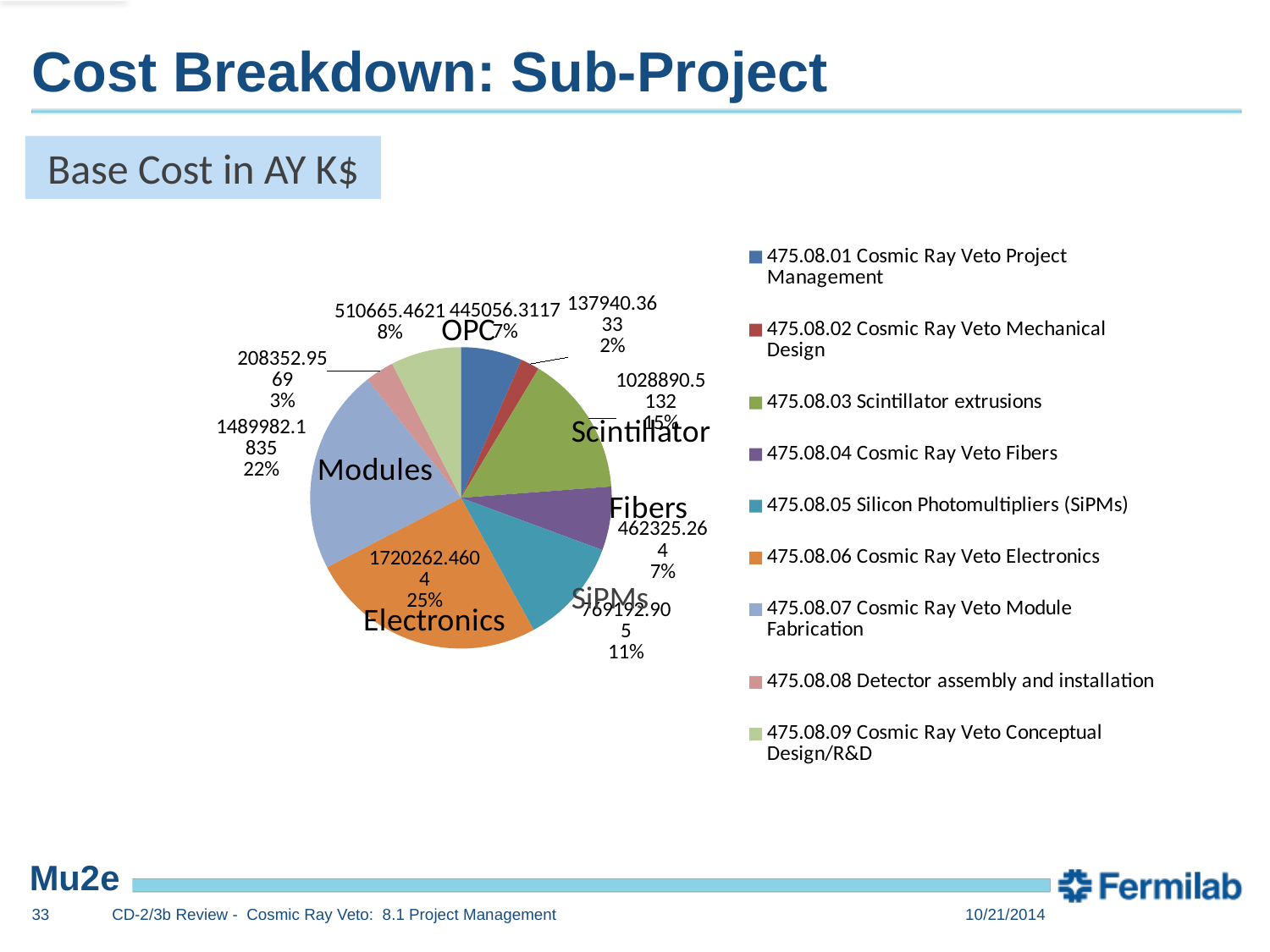
What percentage share does the SiPMs slice have? 11% What percentage share does the Scintillator slice (475.08.03 Scintillator extrusions) have? 15% What percentage share does 475.08.02 Cosmic Ray Veto Mechanical Design have? 2% What is the value shown for 475.08.09 Cosmic Ray Veto Conceptual Design/R&D? 510665.4621 What is the value shown for 475.08.01 Cosmic Ray Veto Project Management? 445056.3117 What kind of chart is shown on the slide? pie chart Which is larger, the Modules slice or the Scintillator slice? Modules Which category has the smallest slice of the pie? 475.08.02 Cosmic Ray Veto Mechanical Design How many slices does the pie chart have? 9 Which category has the largest slice of the pie? 475.08.06 Cosmic Ray Veto Electronics